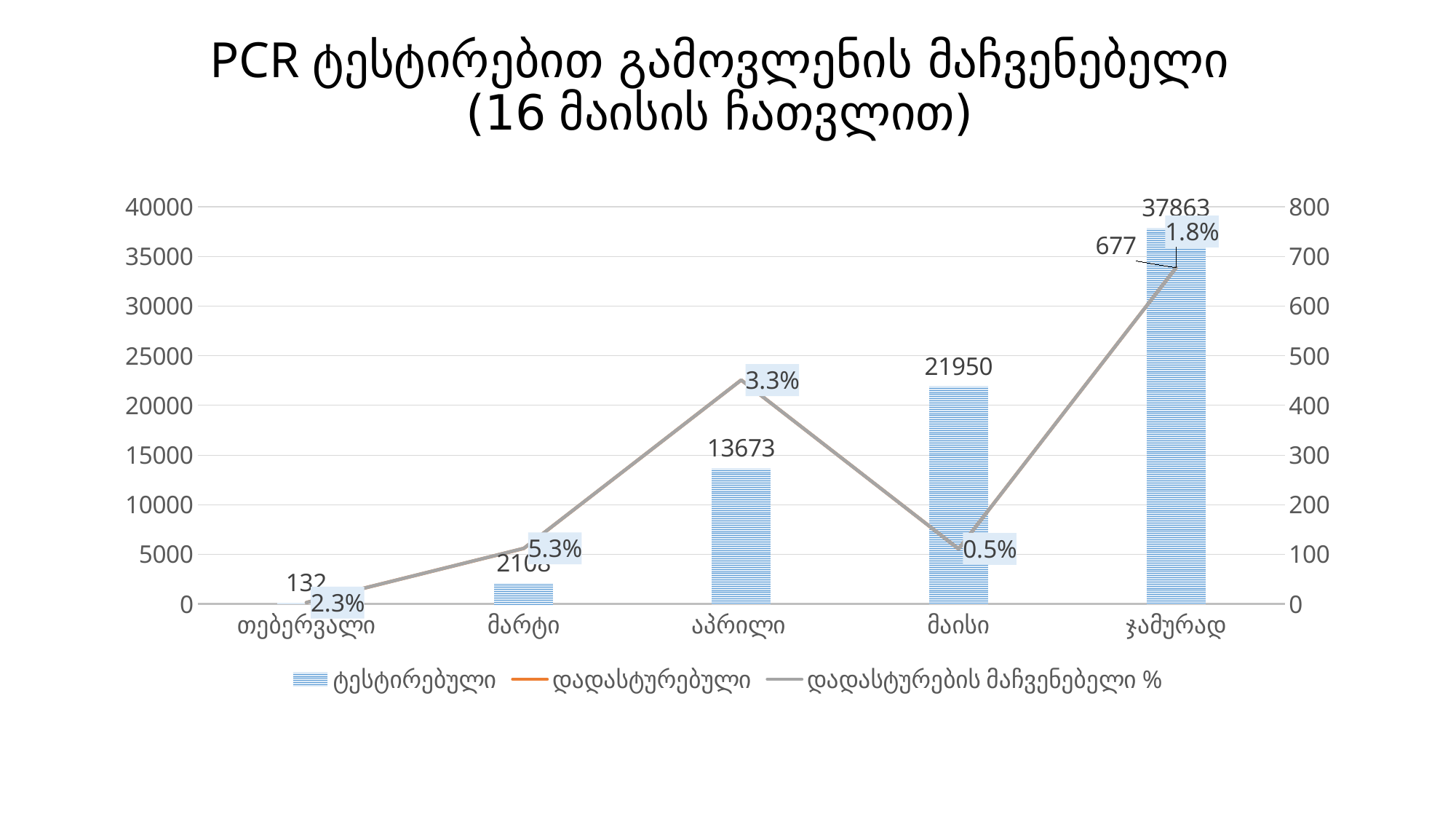
How many series does the legend list? 3 What is the ტესტირებული value for ჯამურად? 37863 What is the difference between the ტესტირებული values for ჯამურად and მაისი? 15913 What is the დადასტურების მაჩვენებელი % value for მაისი? 0.5% How many categories are shown on the x axis? 5 Which category has the lowest დადასტურების მაჩვენებელი % value? მაისი What is the დადასტურების მაჩვენებელი % value for მარტი? 5.3% Which category has the highest ტესტირებული value? ჯამურად Is the ტესტირებული value for აპრილი greater or less than 15000? less What is the ტესტირებული value for აპრილი? 13673 What is the ტესტირებული value for მაისი? 21950 Which category has the highest დადასტურების მაჩვენებელი % value? მარტი